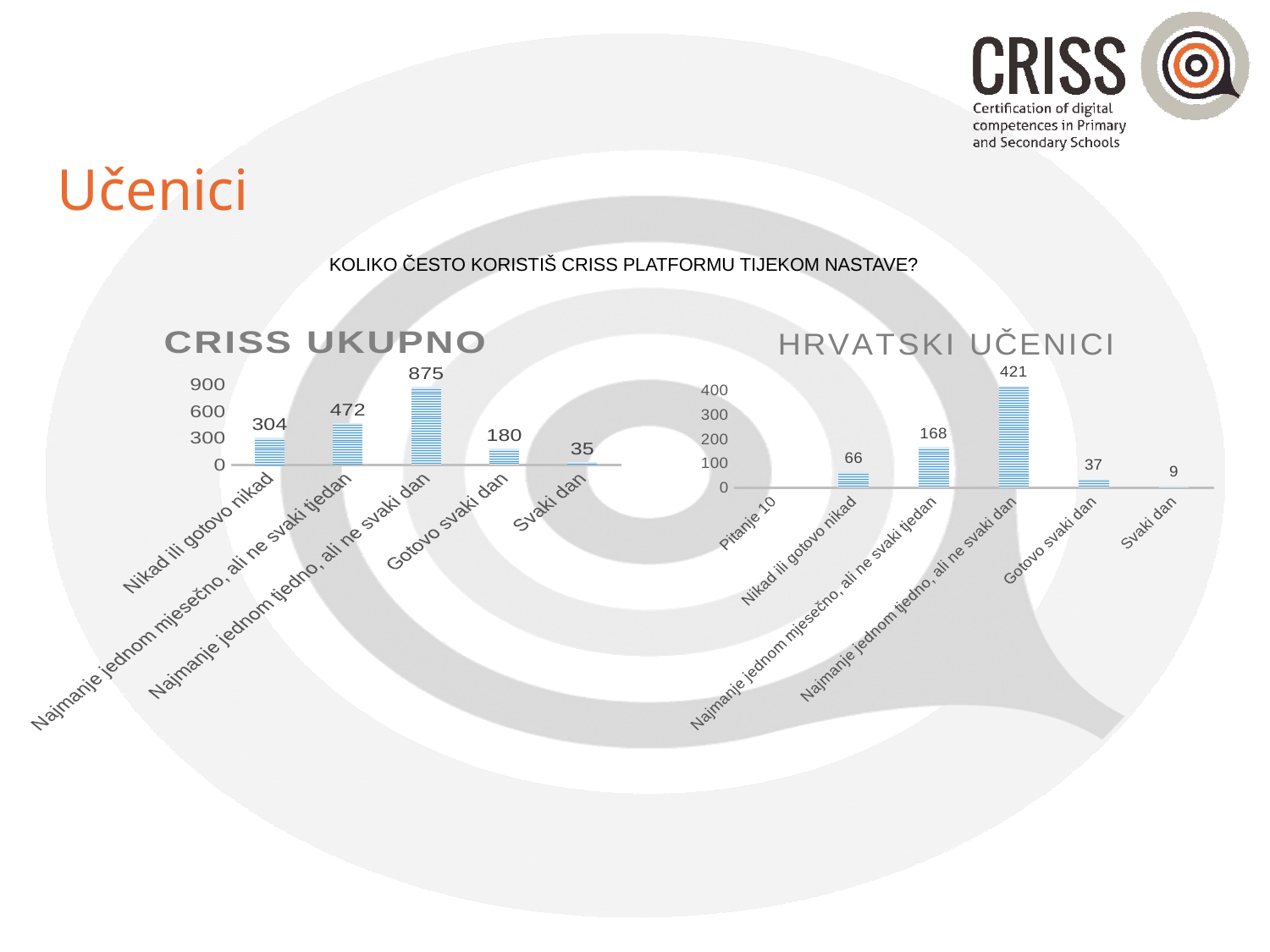
In the CRISS UKUPNO chart, what is the value for "Svaki dan"? 35 In the CRISS UKUPNO chart, how many categories are shown on the x axis? 5 In the HRVATSKI UČENICI chart, which is larger, "Najmanje jednom mjesečno, ali ne svaki tjedan" or "Svaki dan"? Najmanje jednom mjesečno, ali ne svaki tjedan In the CRISS UKUPNO chart, what is the value for "Najmanje jednom tjedno, ali ne svaki dan"? 875 In the HRVATSKI UČENICI chart, what is the difference between "Najmanje jednom tjedno, ali ne svaki dan" and "Najmanje jednom mjesečno, ali ne svaki tjedan"? 253 In the HRVATSKI UČENICI chart, which category has the highest value? Najmanje jednom tjedno, ali ne svaki dan In the CRISS UKUPNO chart, which category has the highest value? Najmanje jednom tjedno, ali ne svaki dan What type of chart is the CRISS UKUPNO chart? Bar chart In the CRISS UKUPNO chart, which category has the lowest value? Svaki dan In the HRVATSKI UČENICI chart, what is the value for "Nikad ili gotovo nikad"? 66 In the HRVATSKI UČENICI chart, what is the value for "Gotovo svaki dan"? 37 In the CRISS UKUPNO chart, what is the difference between "Najmanje jednom mjesečno, ali ne svaki tjedan" and "Nikad ili gotovo nikad"? 168